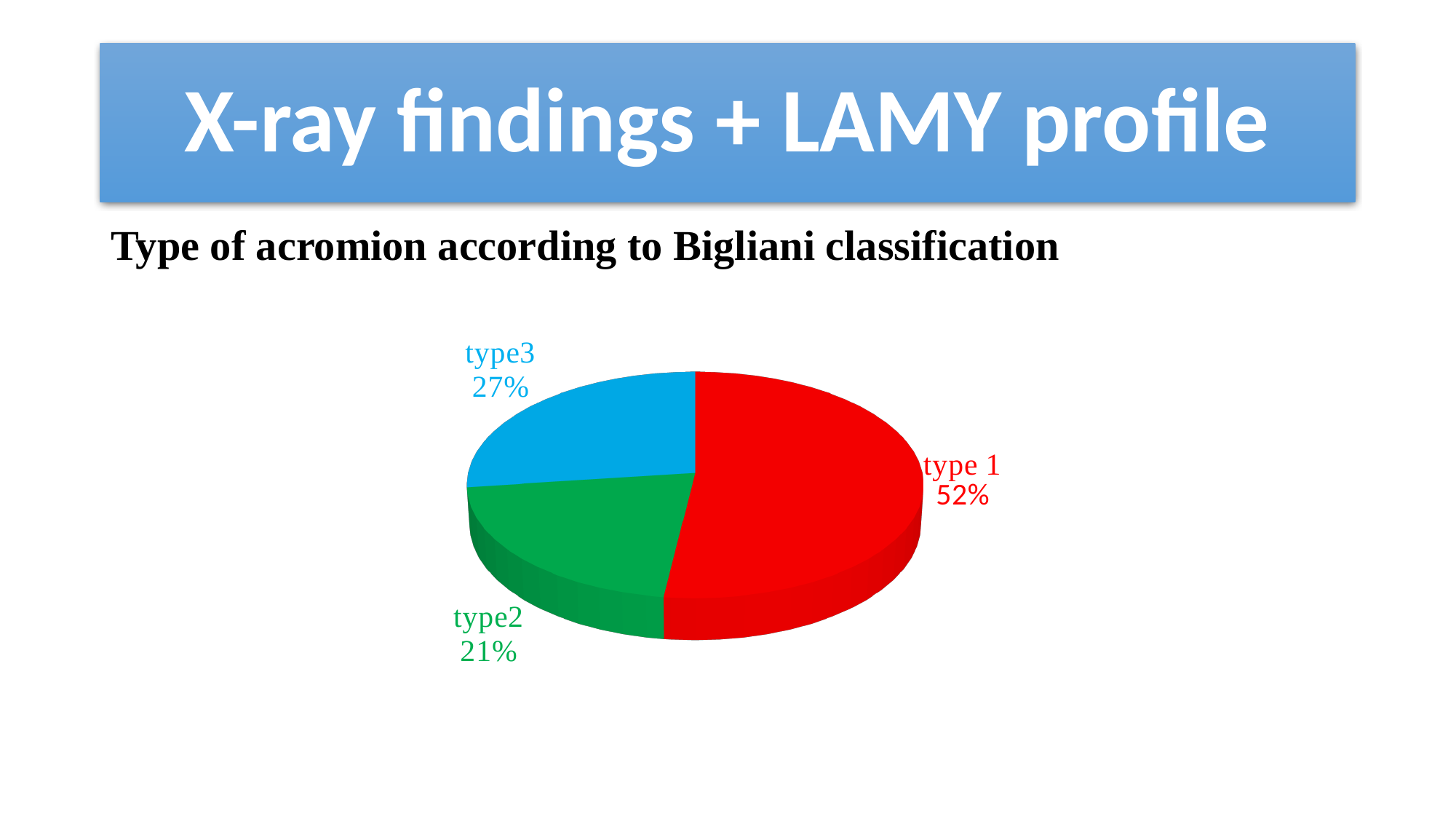
What kind of chart is shown on the slide? pie chart What share of the pie does type2 represent? 21% Which acromion type has the largest share of the pie? type 1 Which has a larger share, type2 or type3? type3 What is the heading above the chart? Type of acromion according to Bigliani classification How many slices does the pie chart have? 3 Which acromion type has the smallest share of the pie? type2 What colour is the type 1 slice? red What share of the pie does type 1 represent? 52% What is the difference in percentage points between type3 and type2? 6 What is the difference in percentage points between type 1 and type3? 25 What share of the pie does type3 represent? 27%